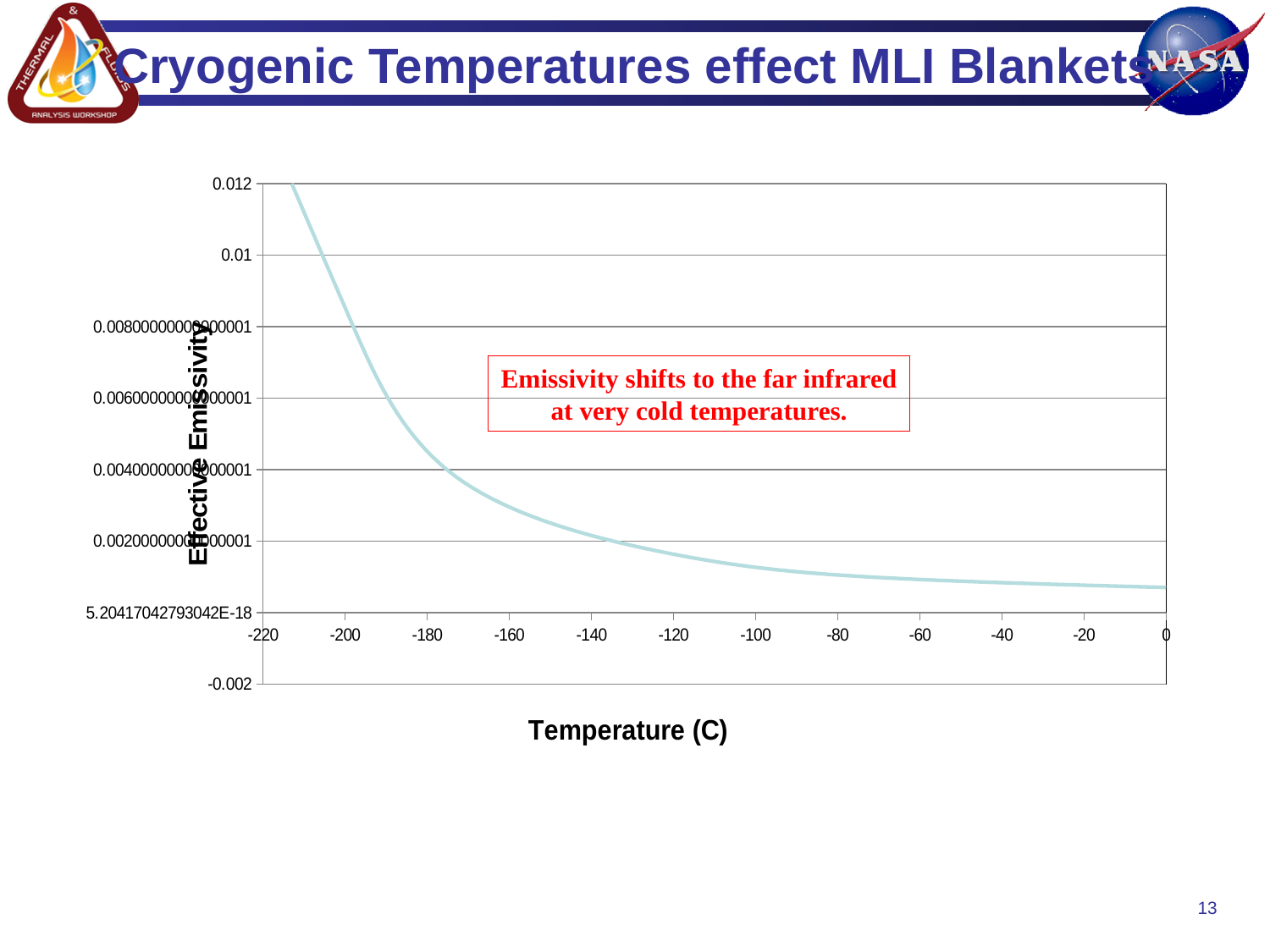
How many lines are plotted on the chart? 1 Is the effective emissivity at -20 C greater or less than 0.002? less What does the red annotation on the chart say? Emissivity shifts to the far infrared at very cold temperatures. Is the effective emissivity at -160 C greater or less than 0.004? less What kind of chart is shown on the slide? line chart Is the effective emissivity at -200 C greater or less than 0.006? greater What is the title of the x axis? Temperature (C) Which temperature has the higher effective emissivity, -200 C or -100 C? -200 C As temperature increases along the x axis, does the effective emissivity rise or fall? fall